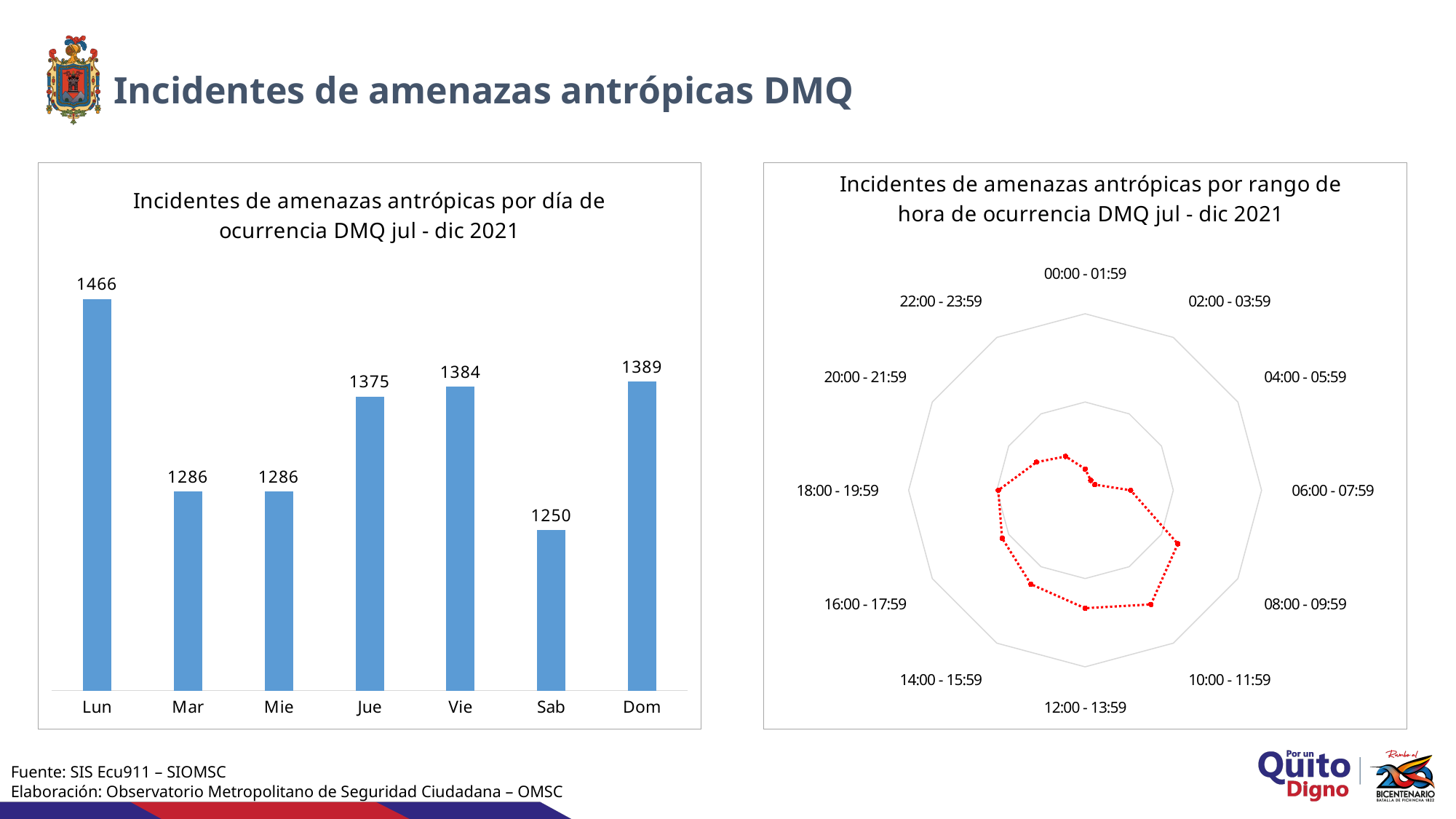
In the chart 'Incidentes de amenazas antrópicas por día de ocurrencia DMQ jul - dic 2021', what is the value for Dom? 1389 In the chart 'Incidentes de amenazas antrópicas por día de ocurrencia DMQ jul - dic 2021', which is larger, the value for Jue or the value for Mar? Jue In the chart 'Incidentes de amenazas antrópicas por día de ocurrencia DMQ jul - dic 2021', what is the value for Lun? 1466 How many days are shown in the chart 'Incidentes de amenazas antrópicas por día de ocurrencia DMQ jul - dic 2021'? 7 In the chart 'Incidentes de amenazas antrópicas por día de ocurrencia DMQ jul - dic 2021', what is the value for Sab? 1250 In the chart 'Incidentes de amenazas antrópicas por día de ocurrencia DMQ jul - dic 2021', what is the difference between the values for Dom and Vie? 5 What kind of chart is the right chart, 'Incidentes de amenazas antrópicas por rango de hora de ocurrencia DMQ jul - dic 2021'? Radar chart What kind of chart is the left chart, 'Incidentes de amenazas antrópicas por día de ocurrencia DMQ jul - dic 2021'? Bar chart How many time ranges are shown in the chart 'Incidentes de amenazas antrópicas por rango de hora de ocurrencia DMQ jul - dic 2021'? 12 In the chart 'Incidentes de amenazas antrópicas por día de ocurrencia DMQ jul - dic 2021', which day has the highest value? Lun In the chart 'Incidentes de amenazas antrópicas por día de ocurrencia DMQ jul - dic 2021', which day has the lowest value? Sab In the chart 'Incidentes de amenazas antrópicas por día de ocurrencia DMQ jul - dic 2021', what is the difference between the values for Lun and Sab? 216